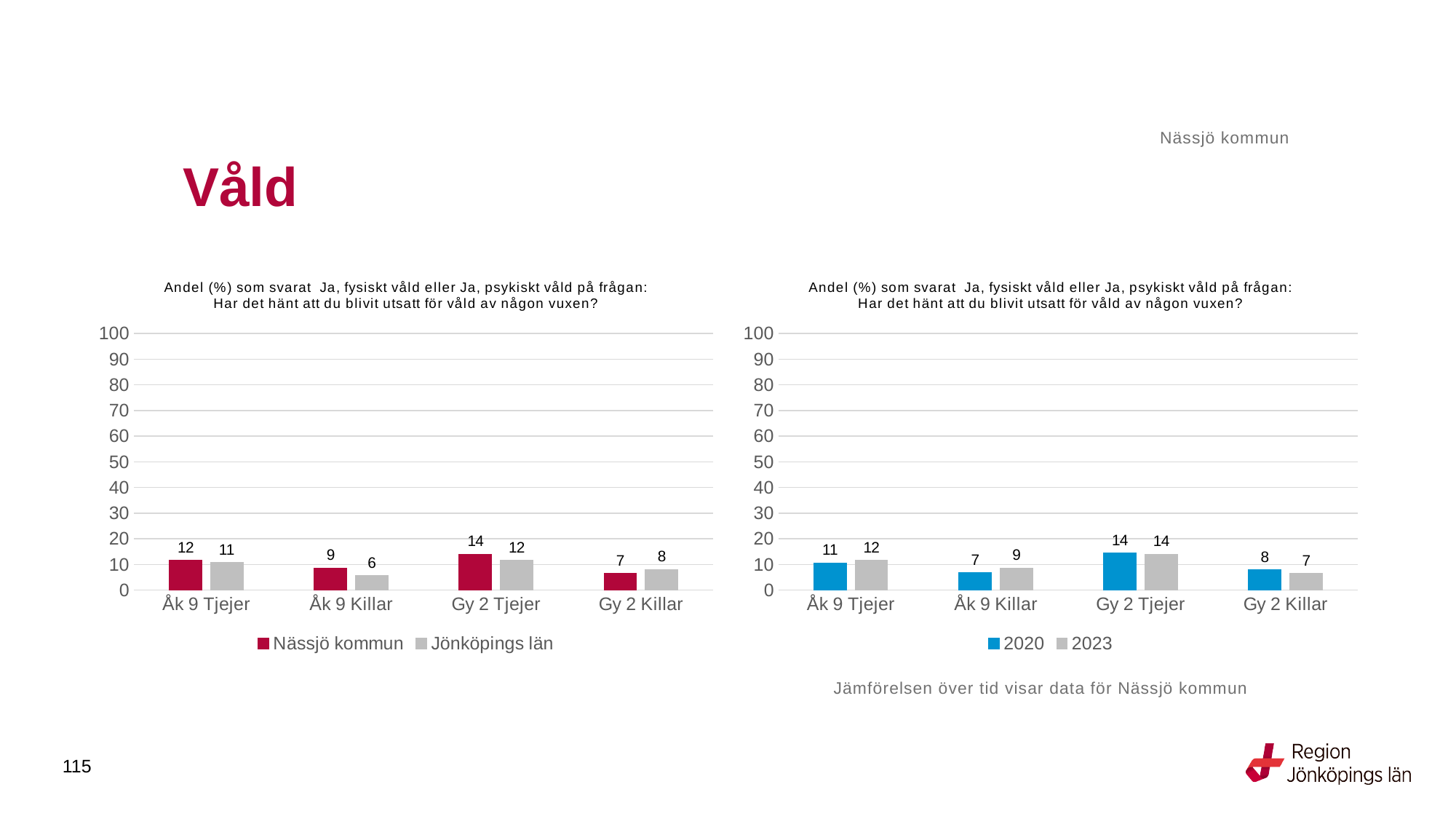
In the right chart, which is larger for Åk 9 Tjejer, 2020 or 2023? 2023 What type of chart is the right chart? Bar chart In the right chart, what are the two legend entries? 2020 and 2023 In the left chart, what is the value for Jönköpings län for Åk 9 Killar? 6 In the left chart, what is the value for Nässjö kommun for Åk 9 Tjejer? 12 In the left chart, what is the difference between Nässjö kommun and Jönköpings län for Åk 9 Killar? 3 In the right chart, what is the value for 2020 for Gy 2 Killar? 8 In the left chart, how many series does the legend list? 2 In the right chart, what is the value for 2023 for Åk 9 Killar? 9 In the left chart, which category has the lowest value for Jönköpings län? Åk 9 Killar In the right chart, how many categories are shown on the x axis? 4 In the left chart, which category has the highest value for Nässjö kommun? Gy 2 Tjejer